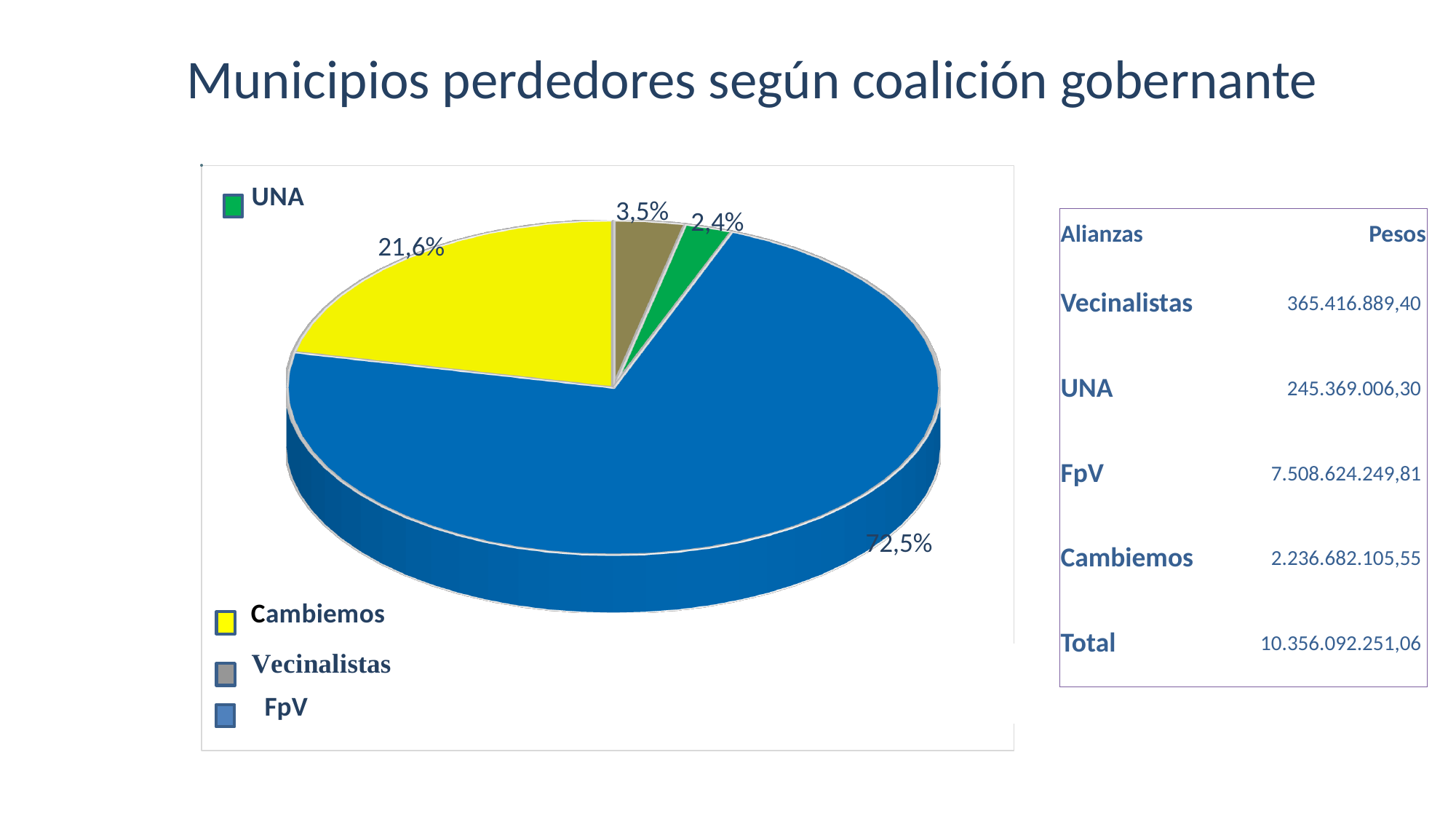
How many percentage points larger is the FpV slice than the Cambiemos slice? 50,9 What share of the pie does FpV hold? 72,5% What kind of chart is shown on the slide? Pie chart Which slice is larger, Cambiemos or Vecinalistas? Cambiemos Which coalition has the largest slice of the pie? FpV What is the title of the slide? Municipios perdedores según coalición gobernante Which coalition has the smallest slice of the pie? UNA How many slices does the pie chart have? 4 What share of the pie does Vecinalistas hold? 3,5% Which colour represents Cambiemos in the pie chart? Yellow What share of the pie does UNA hold? 2,4%